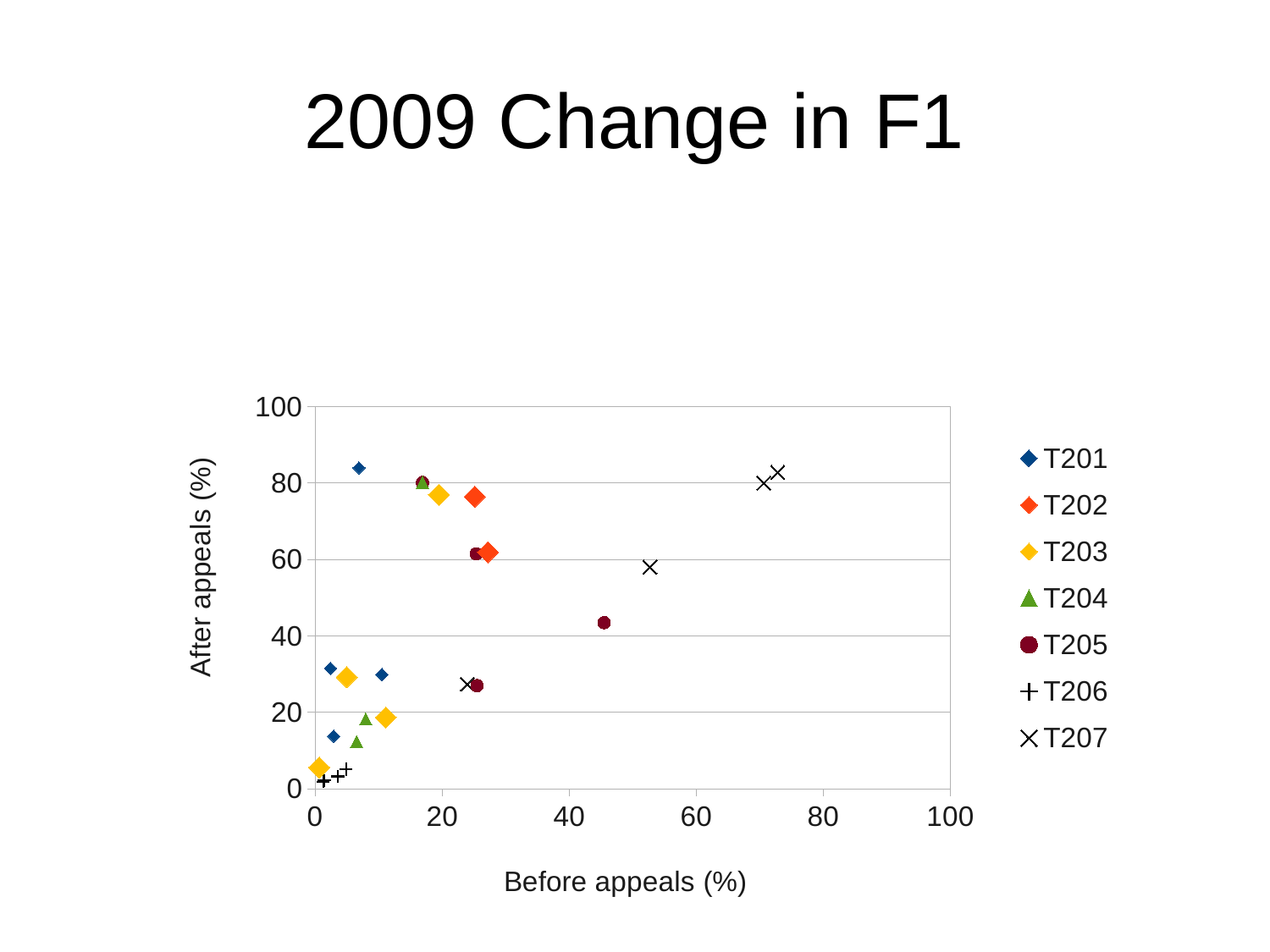
Is the After appeals value for the T202 point near Before appeals 26 greater or less than 60? greater Is the After appeals value for the T205 point near Before appeals 45 greater or less than 60? less How many T202 points are plotted? 2 Which series has the point with the highest Before appeals value? T207 Which series has a higher Before appeals value for its rightmost point, T207 or T205? T207 How many series does the legend list? 7 How many T207 points are plotted? 4 What is the label of the horizontal axis? Before appeals (%) What kind of chart is shown on the slide? scatter chart What is the title of the chart? 2009 Change in F1 Is the After appeals value for the T206 points greater or less than 20? less